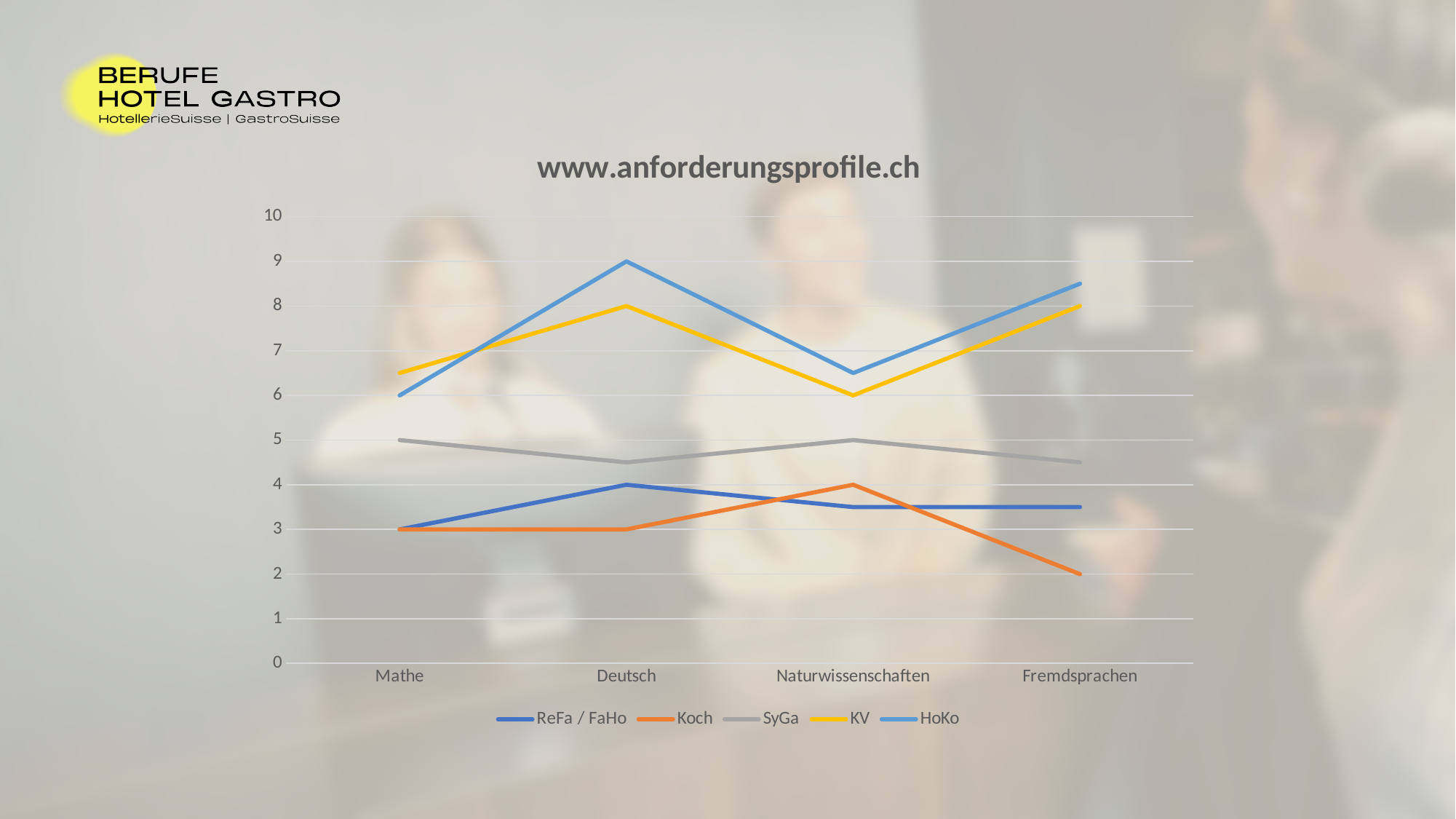
Is the value for HoKo at Fremdsprachen greater or less than 8? greater What is the difference between the HoKo and KV values at Deutsch? 1 How many categories are shown on the x axis? 4 What is the value for HoKo at Deutsch? 9 What is the value for KV at Naturwissenschaften? 6 Which series has the lowest value at Fremdsprachen? Koch How many series does the legend list? 5 What is the value for Koch at Fremdsprachen? 2 Which series has the highest value at Deutsch? HoKo What kind of chart is shown on the slide? line chart What is the title of the chart? www.anforderungsprofile.ch Which is larger at Naturwissenschaften, the value for Koch or the value for ReFa / FaHo? Koch